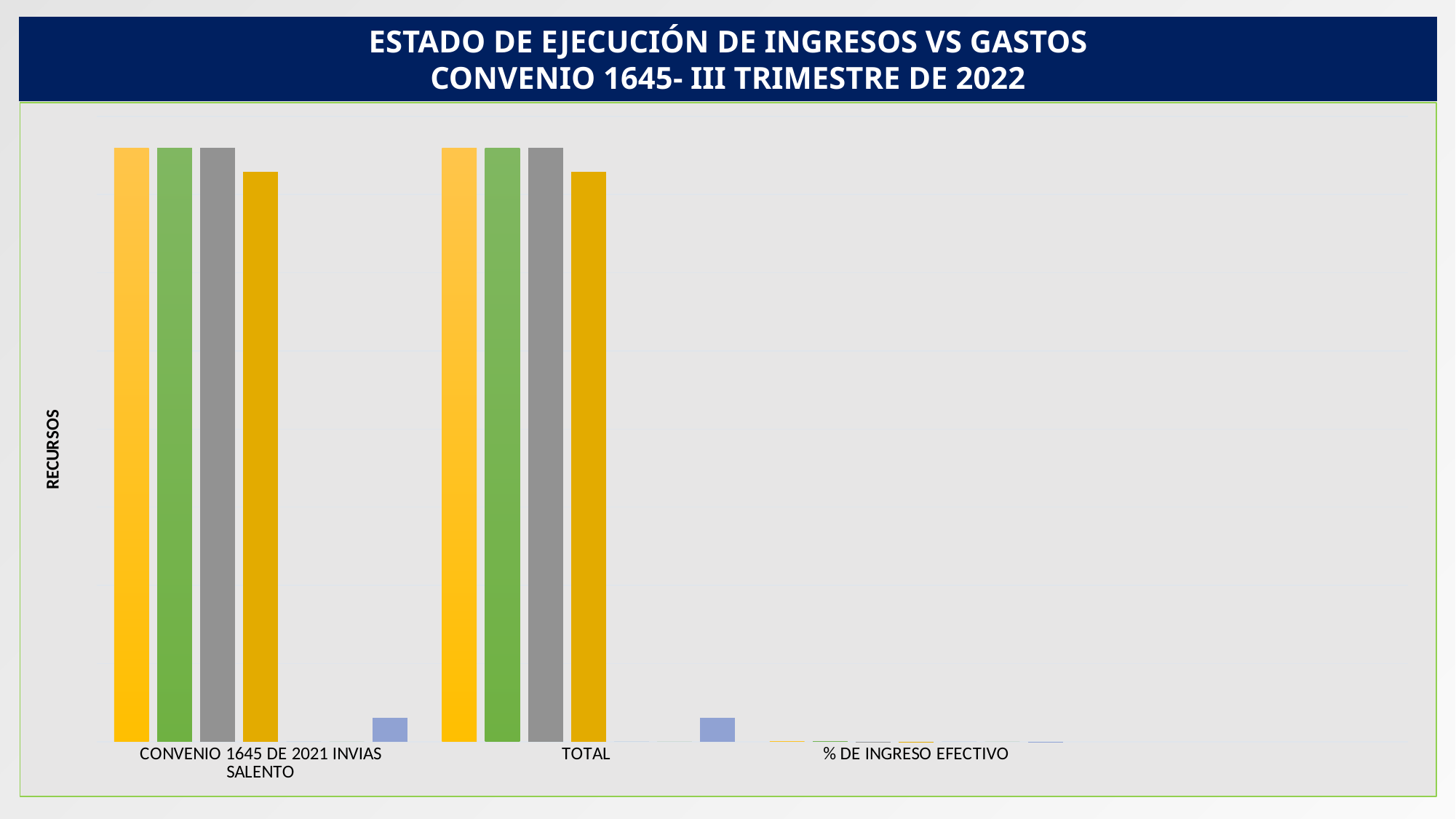
What kind of chart is shown on the slide? bar chart Which category has the lowest bars in the chart? % DE INGRESO EFECTIVO What is the title of the chart? ESTADO DE EJECUCIÓN DE INGRESOS VS GASTOS CONVENIO 1645- III TRIMESTRE DE 2022 Are the bars for % DE INGRESO EFECTIVO taller or shorter than the bars for TOTAL? shorter What is the label on the vertical axis of the chart? RECURSOS How many categories are shown on the x axis of the chart? 3